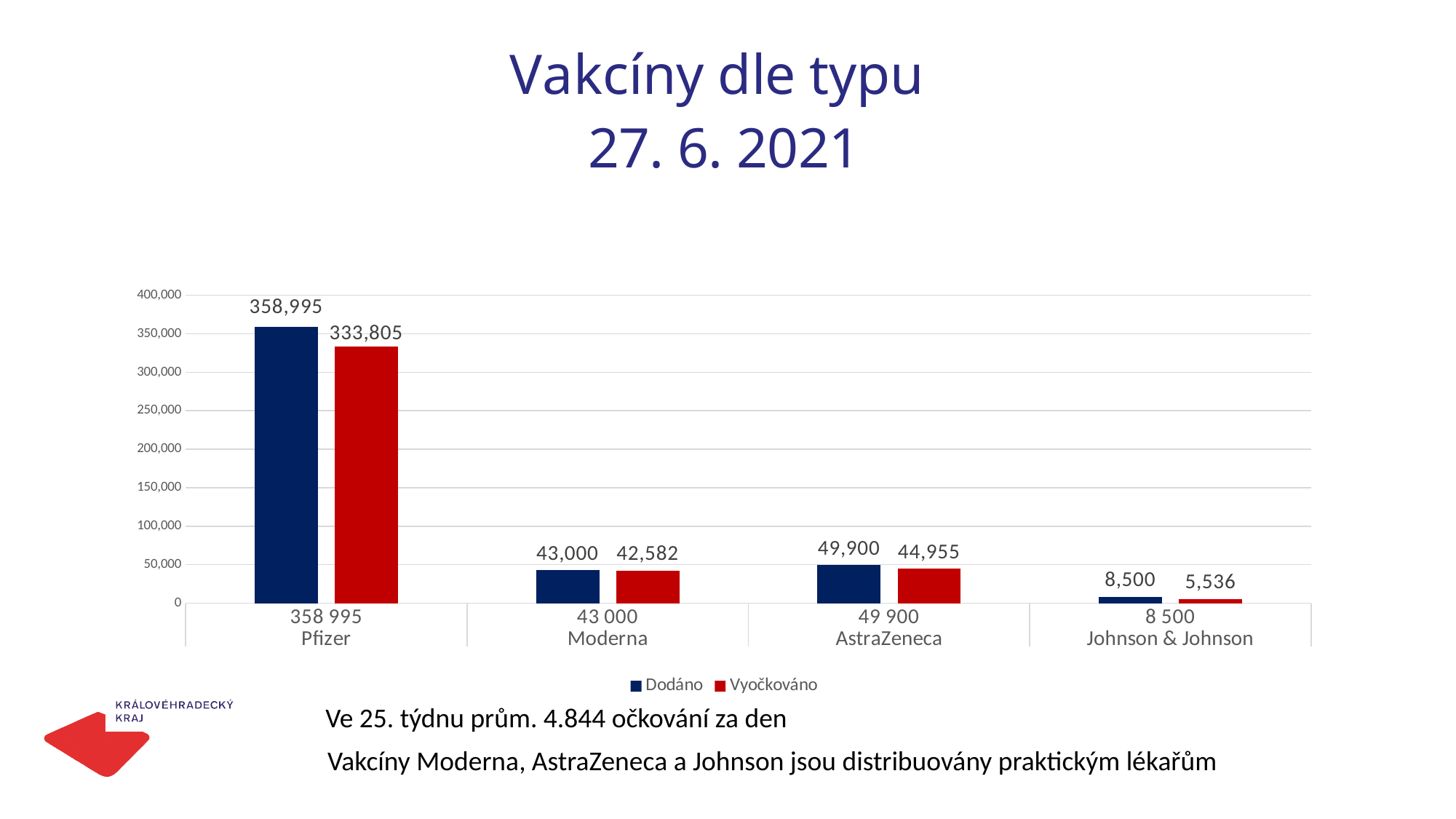
Which vaccine has the highest Dodáno value? Pfizer What is the Vyočkováno value for AstraZeneca? 44,955 What is the Vyočkováno value for Johnson & Johnson? 5,536 What is the difference between the Dodáno and Vyočkováno values for Pfizer? 25,190 Which vaccine has the lowest Vyočkováno value? Johnson & Johnson Which is larger: the Dodáno value for AstraZeneca or the Dodáno value for Moderna? AstraZeneca What is the difference between the Dodáno values for AstraZeneca and Moderna? 6,900 How many vaccine types are shown on the x axis? 4 What is the Dodáno value for Moderna? 43,000 What kind of chart is shown on the slide? Bar chart How many series does the legend list? 2 What is the Dodáno value for Pfizer? 358,995